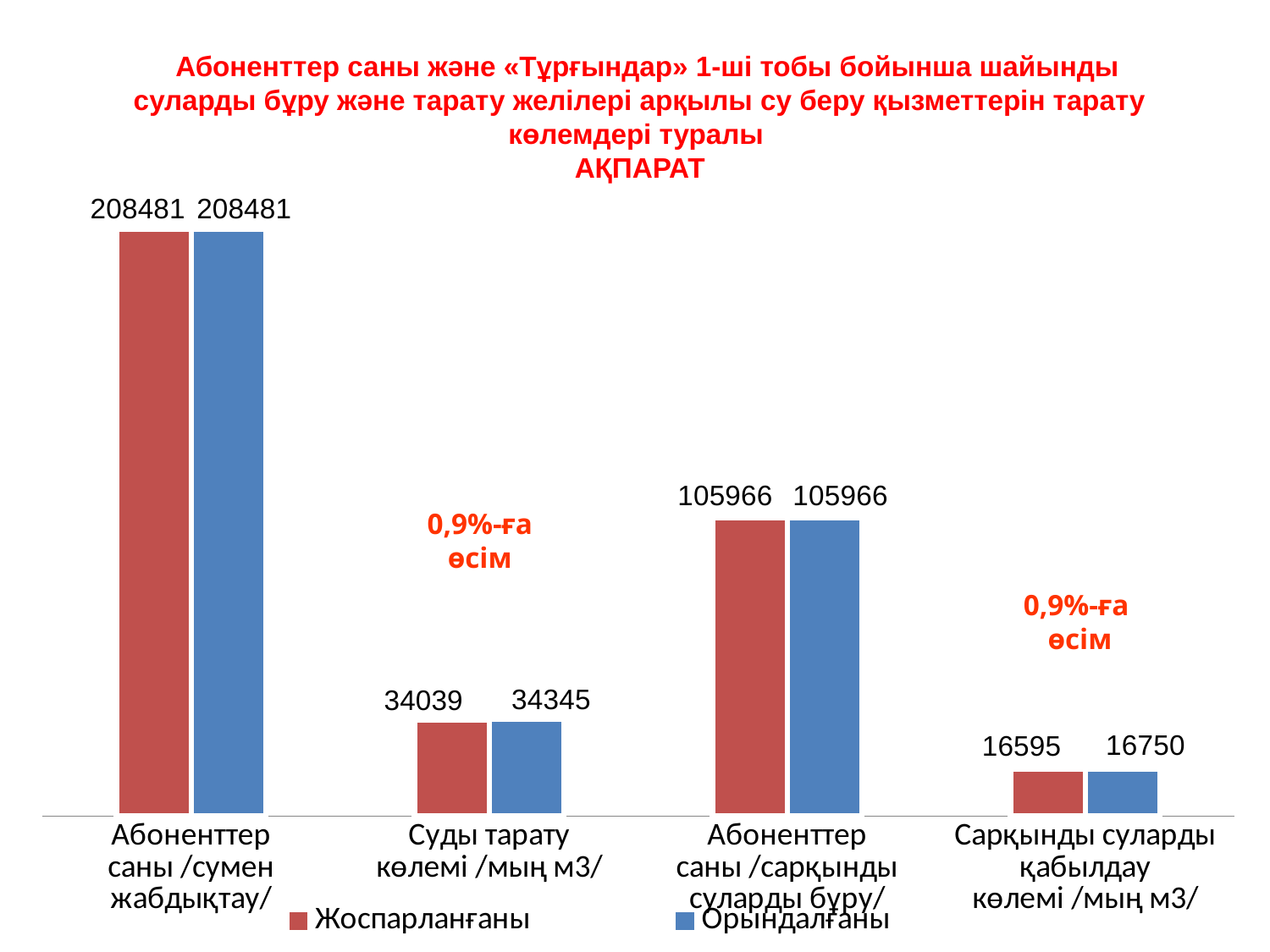
What is the difference between the Орындалғаны and Жоспарланғаны values for Сарқынды суларды қабылдау көлемі /мың м3/? 155 What type of chart is shown on the slide? Bar chart Which category has the lowest Орындалғаны value? Сарқынды суларды қабылдау көлемі /мың м3/ Which is larger for Сарқынды суларды қабылдау көлемі /мың м3/: the Жоспарланғаны value or the Орындалғаны value? Орындалғаны What is the planned (Жоспарланғаны) value for Суды тарату көлемі /мың м3/? 34039 What is the difference between the Орындалғаны and Жоспарланғаны values for Суды тарату көлемі /мың м3/? 306 How many categories are shown on the x axis of the chart? 4 How many series does the legend list? 2 What is the actual (Орындалғаны) value for Суды тарату көлемі /мың м3/? 34345 What is the Орындалғаны value for Сарқынды суларды қабылдау көлемі /мың м3/? 16750 Which category has the highest Жоспарланғаны value? Абоненттер саны /сумен жабдықтау/ What is the Жоспарланғаны value for Абоненттер саны /сарқынды суларды бұру/? 105966